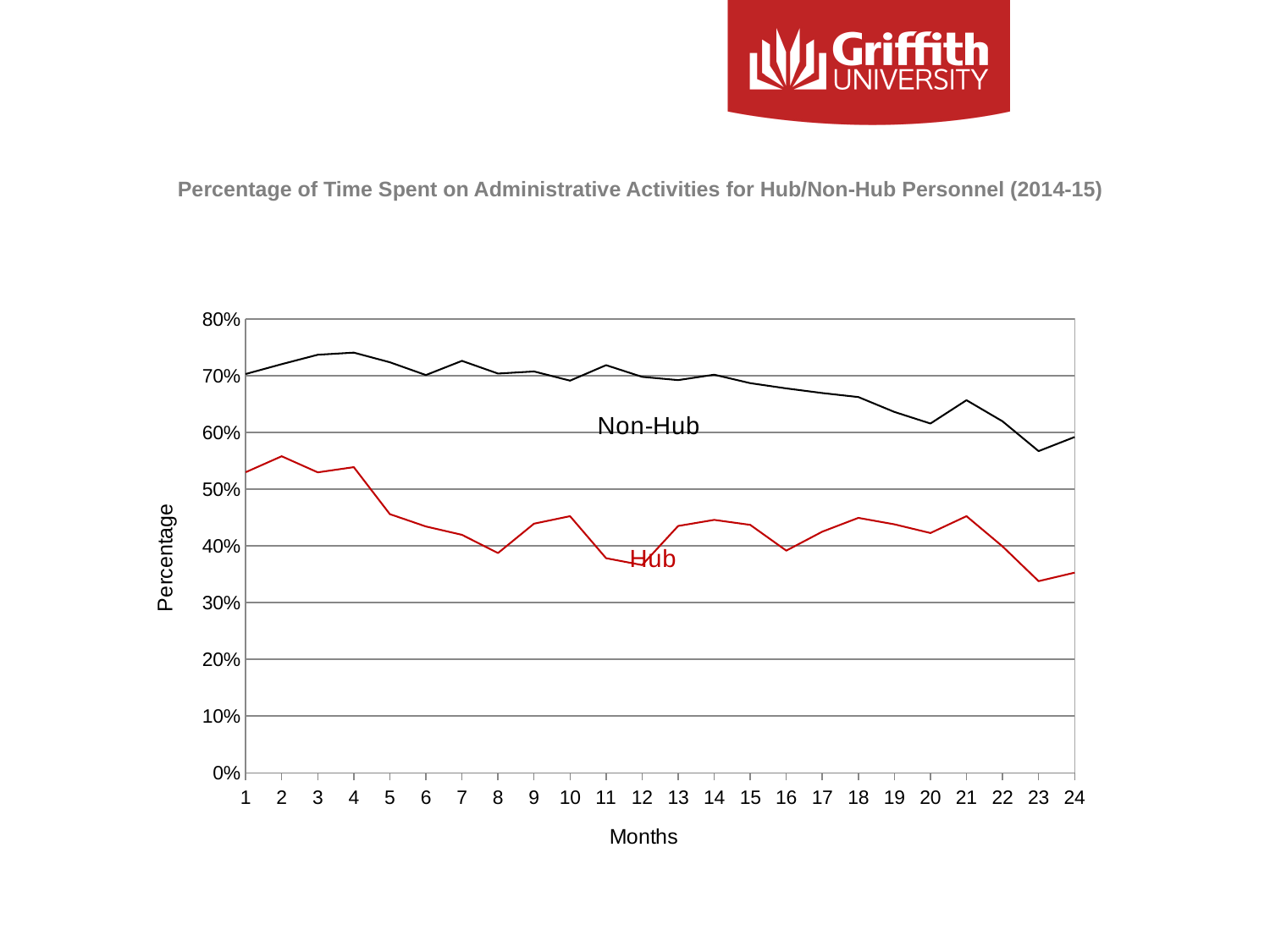
Is the Hub value at month 23 greater or less than 40%? less What is the label on the x axis of the chart? Months What kind of chart is shown on the slide? line chart How many months are plotted along the x axis? 24 Is the Hub value at month 1 greater or less than 50%? greater Is the Non-Hub value at month 23 greater or less than 60%? less Is the Hub value larger at month 2 or at month 8? month 2 At which month is the Non-Hub value lowest? 23 How many series are plotted on the chart? 2 Which series has the higher value at month 1, Hub or Non-Hub? Non-Hub Does the Non-Hub line generally rise or fall from month 1 to month 24? fall